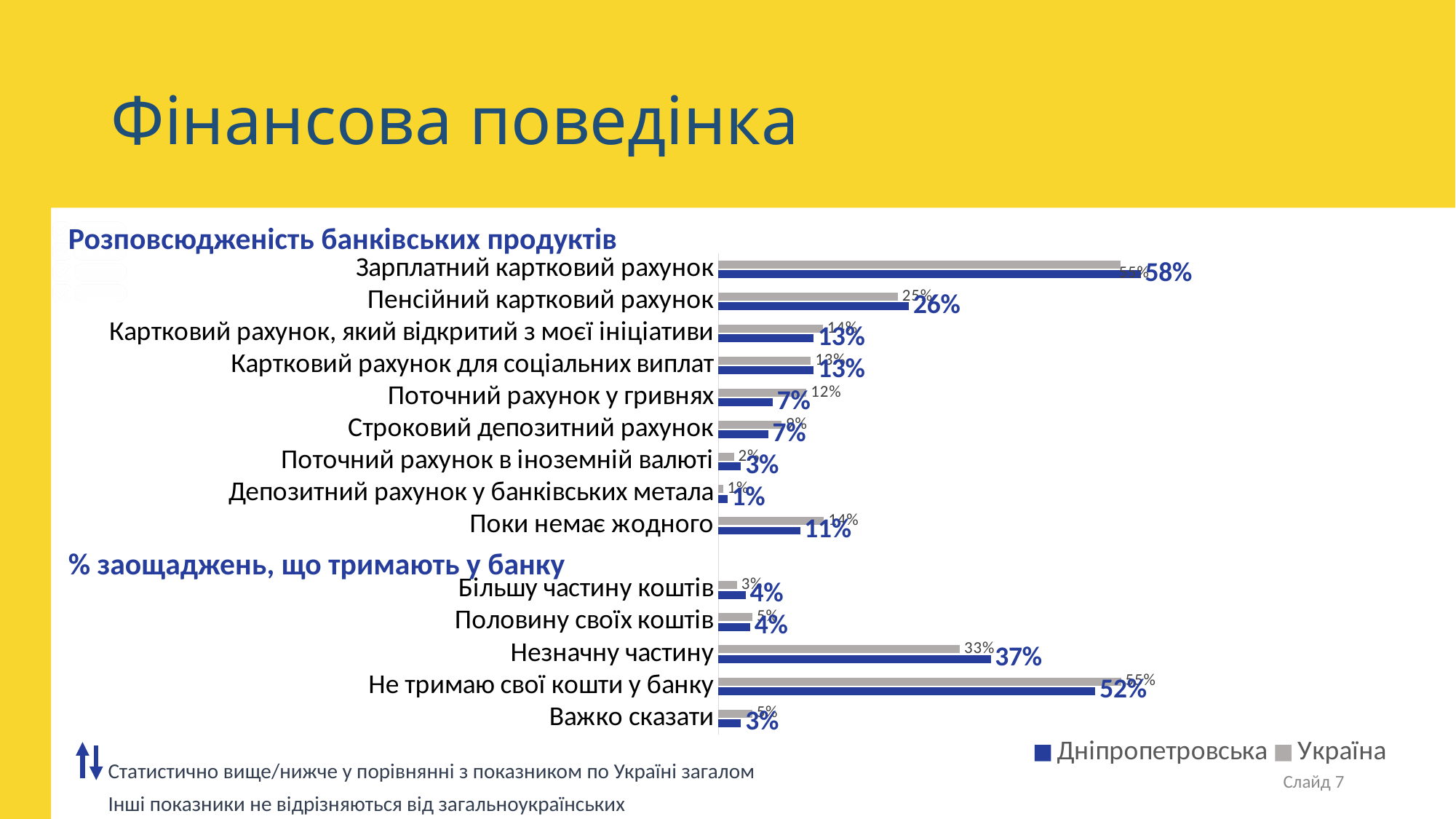
How many categories are shown in the % заощаджень, що тримають у банку section? 5 Which banking product has the highest Дніпропетровська value in the Розповсюдженість банківських продуктів section? Зарплатний картковий рахунок What is the Україна value for Поточний рахунок у гривнях? 12% Which category has the lowest Дніпропетровська value in the Розповсюдженість банківських продуктів section? Депозитний рахунок у банківських метала Which is larger for Поки немає жодного: the Дніпропетровська value or the Україна value? Україна What is the Україна value for Не тримаю свої кошти у банку? 55% What is the Дніпропетровська value for Зарплатний картковий рахунок? 58% What is the difference between the Дніпропетровська and Україна values for Поточний рахунок у гривнях? 5% What is the difference between the Дніпропетровська and Україна values for Незначну частину? 4% What type of chart is shown on the slide? Bar chart What is the Дніпропетровська value for Незначну частину? 37% How many series does the legend list? 2